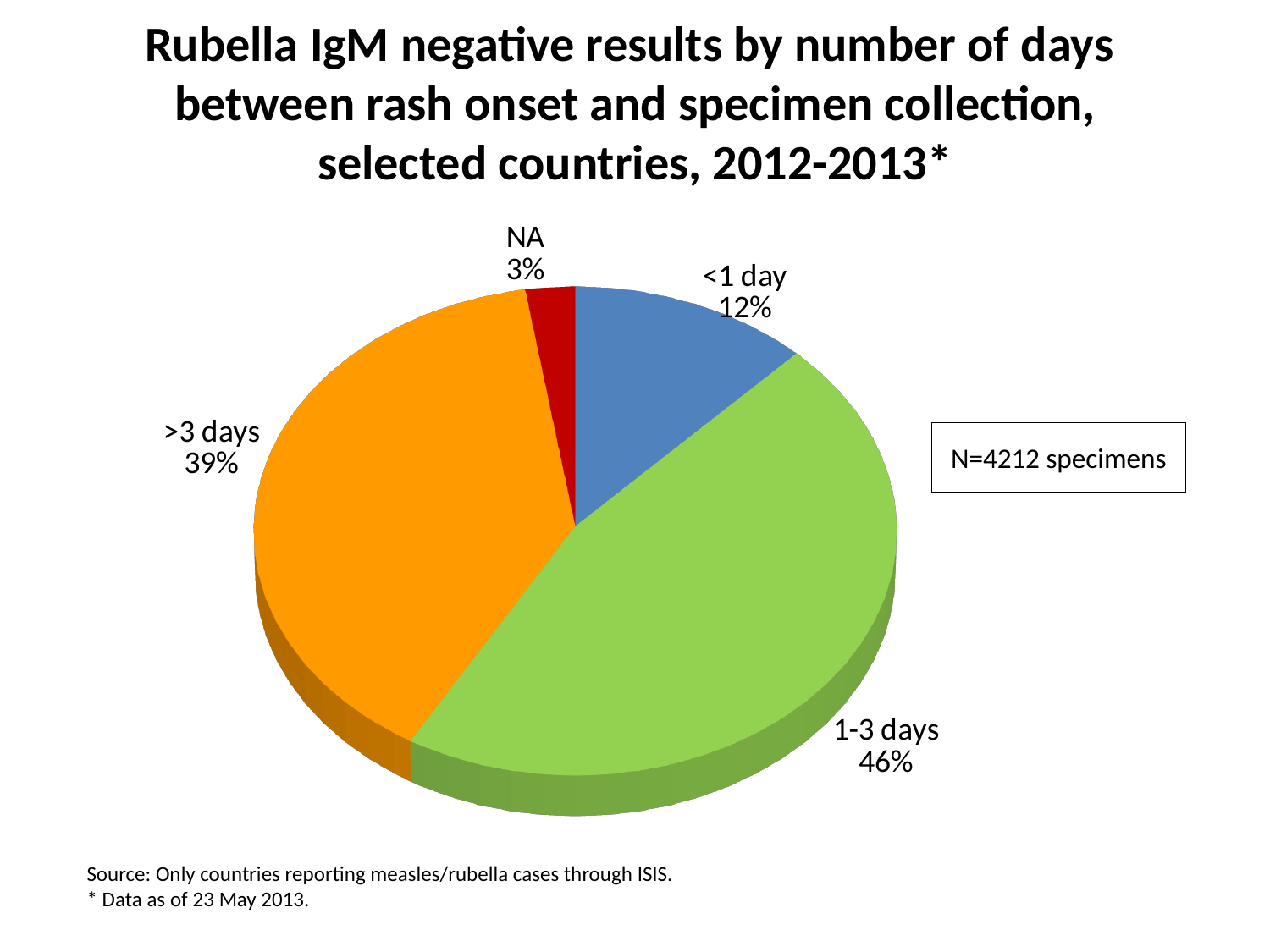
How many specimens does the chart represent, according to the text box on the slide? 4212 What colour is the 1-3 days slice? green What share of the pie does the 1-3 days slice represent? 46% What share of the pie does the >3 days slice represent? 39% What kind of chart is shown on the slide? pie chart How many slices does the pie chart have? 4 What share of the pie does the NA slice represent? 3% Which category has the largest slice of the pie? 1-3 days Which slice is larger, <1 day or >3 days? >3 days What is the difference in percentage points between the 1-3 days slice and the >3 days slice? 7 Which category has the smallest slice of the pie? NA